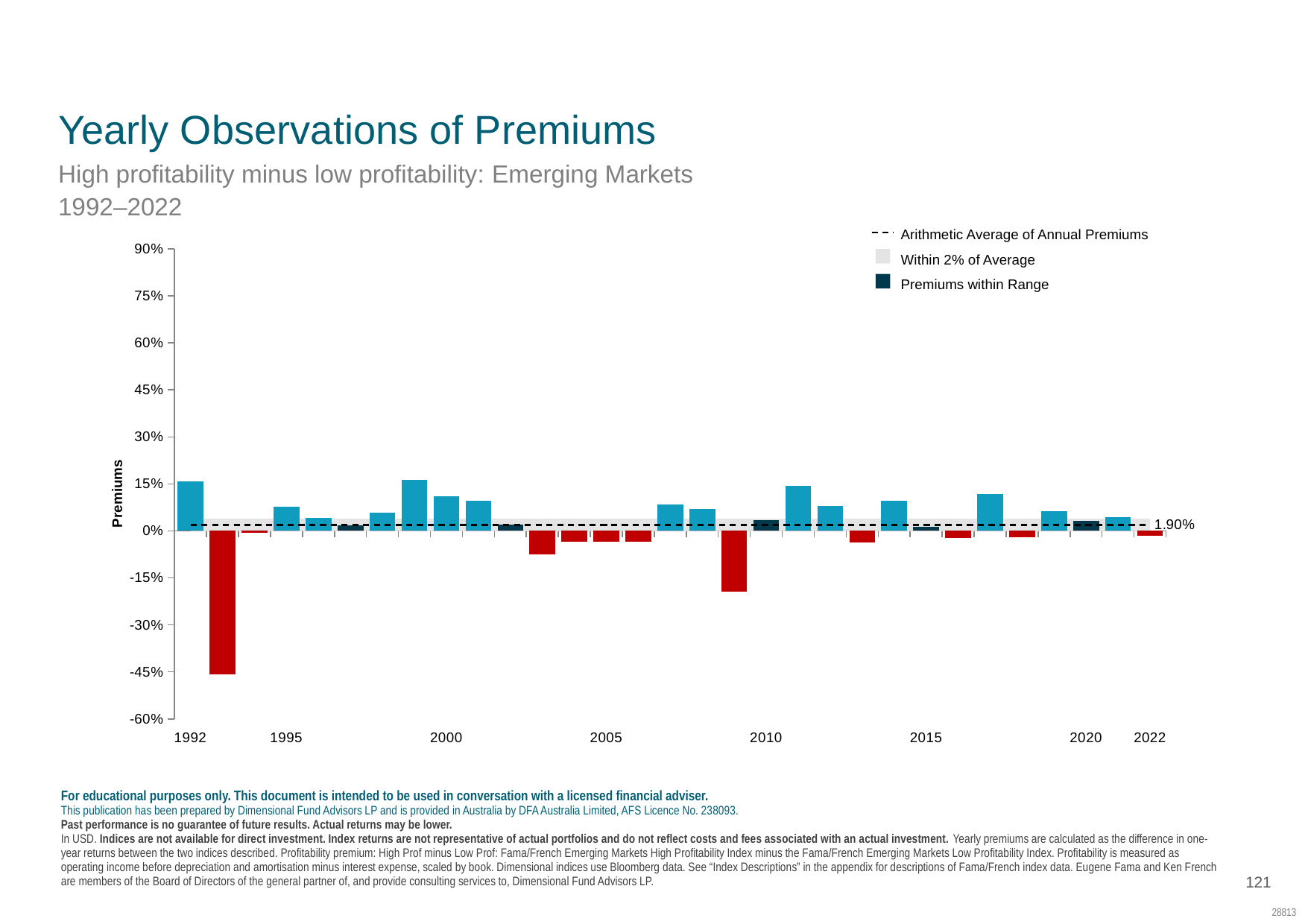
What does the dashed horizontal line on the chart represent? Arithmetic Average of Annual Premiums Is the premium for 2000 greater or less than 15%? less How many entries does the chart legend list? 3 Is the premium for 2022 greater or less than 0%? less What kind of chart is shown on the slide? bar chart Which year has the larger premium, 1995 or 2005? 1995 Is the premium for 1992 greater or less than 0%? greater What is the arithmetic average of annual premiums shown on the chart? 1.90% Which year has the larger premium, 1992 or 2000? 1992 How many yearly bars are plotted on the chart (1992 through 2022)? 31